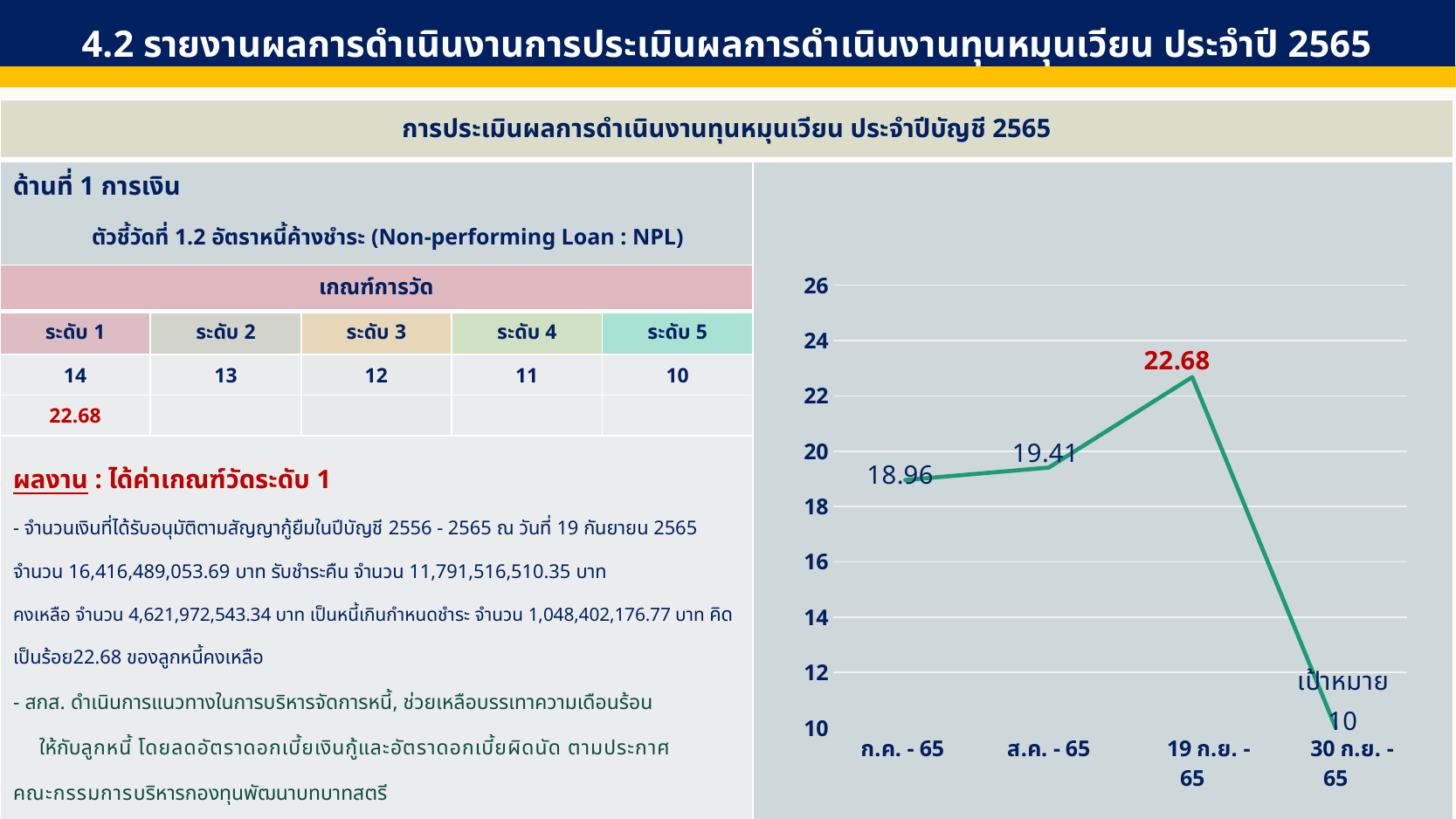
What is the value plotted for 30 ก.ย. - 65? 10 What is the value plotted for 19 ก.ย. - 65? 22.68 Which category has the highest value on the chart? 19 ก.ย. - 65 Which is larger, the value for ก.ค. - 65 or the value for ส.ค. - 65? ส.ค. - 65 What is the value plotted for ก.ค. - 65? 18.96 What type of chart is shown on the slide? line chart How many data points are plotted on the chart? 4 What label appears next to the last data point on the chart? เป้าหมาย What is the difference between the values for 19 ก.ย. - 65 and ส.ค. - 65? 3.27 Which category has the lowest value on the chart? 30 ก.ย. - 65 Is the value for 19 ก.ย. - 65 greater or less than 22? greater What is the value plotted for ส.ค. - 65? 19.41